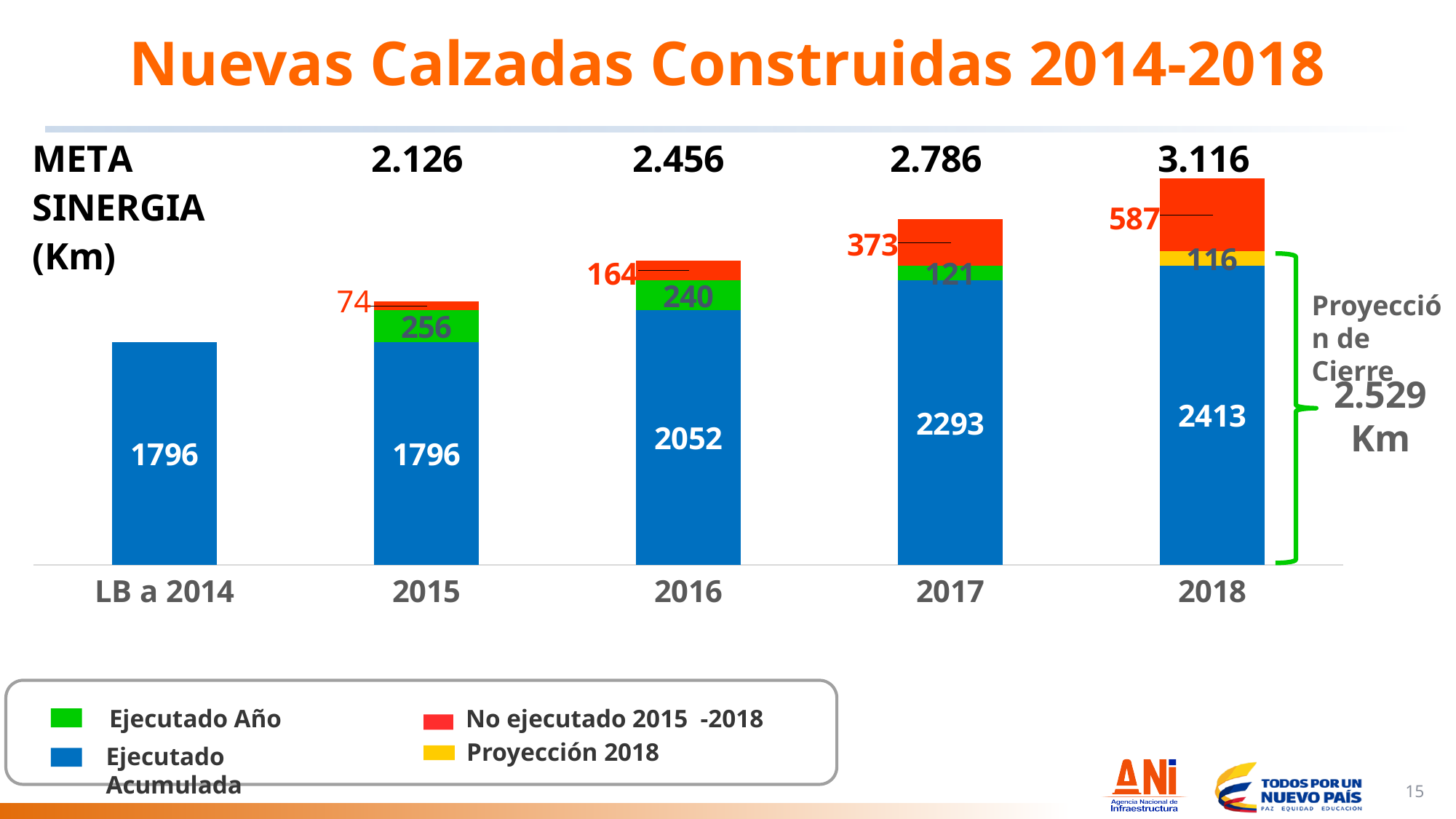
Which year has the highest No ejecutado 2015-2018 value? 2018 What is the Ejecutado Año value for 2016? 240 Does the Ejecutado Acumulada value rise or fall from 2015 to 2018? Rises What kind of chart is shown on the slide? Stacked bar chart How many series does the legend list? 4 What is the Ejecutado Acumulada value for 2018? 2413 What is the Proyección 2018 value shown on the 2018 bar? 116 Which year has the lowest Ejecutado Año value? 2017 What is the No ejecutado 2015-2018 value shown for 2017? 373 What is the difference between the Ejecutado Acumulada values for 2018 and 2017? 120 Which year has the larger Ejecutado Año value, 2015 or 2016? 2015 How many categories are shown on the x axis? 5